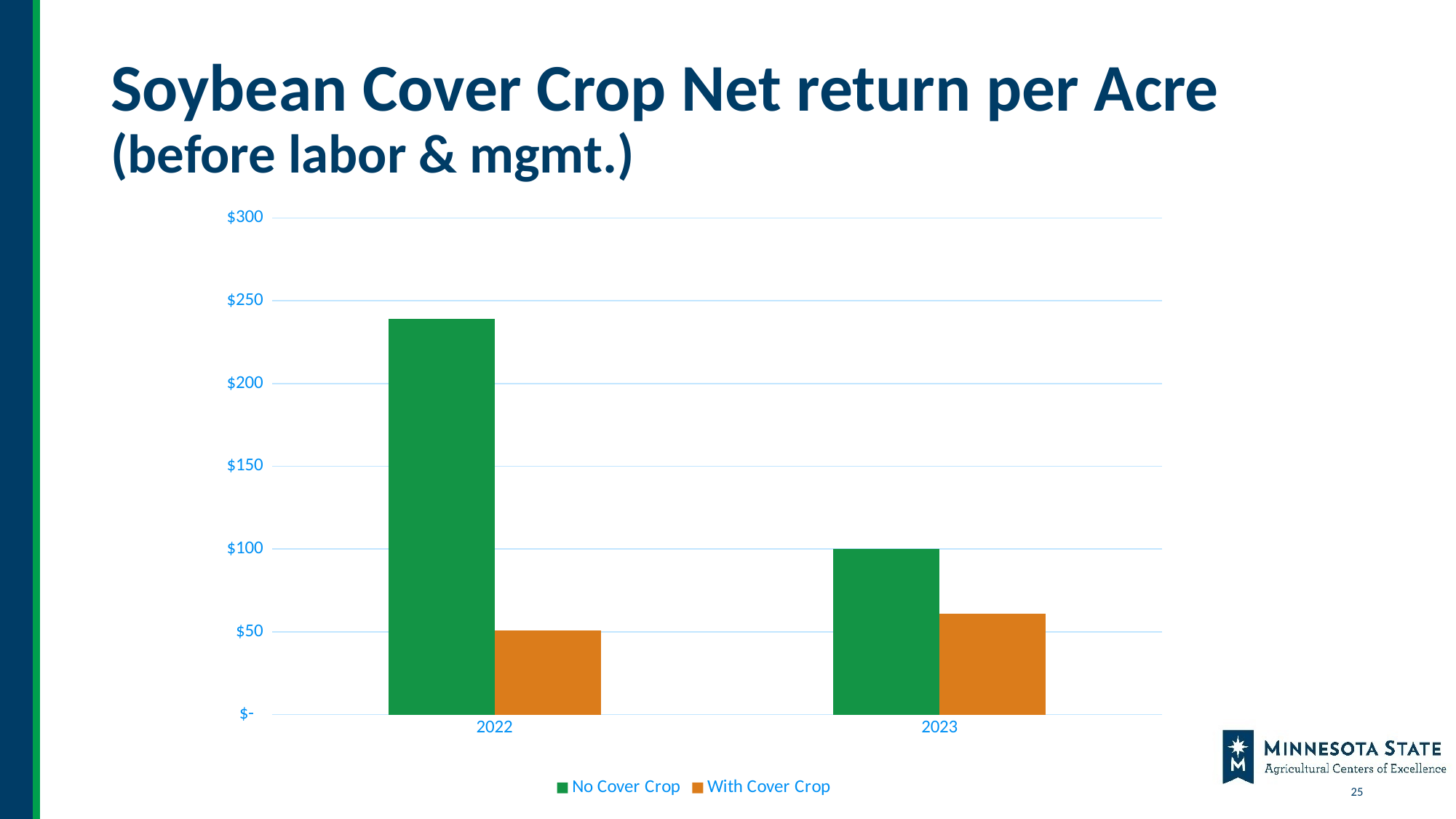
Is the value for No Cover Crop in 2023 greater or less than $150? less Which series is shown in orange in the legend? With Cover Crop Is the value for No Cover Crop in 2022 greater or less than $200? greater How many years are shown on the x axis? 2 Which bar is the highest on the chart? No Cover Crop in 2022 Is the value for With Cover Crop in 2023 greater or less than $50? greater In 2023, which is larger: No Cover Crop or With Cover Crop? No Cover Crop Does the No Cover Crop net return rise or fall from 2022 to 2023? Fall Which bar is the lowest on the chart? With Cover Crop in 2022 What kind of chart is shown on the slide? Bar chart How many series does the legend list? 2